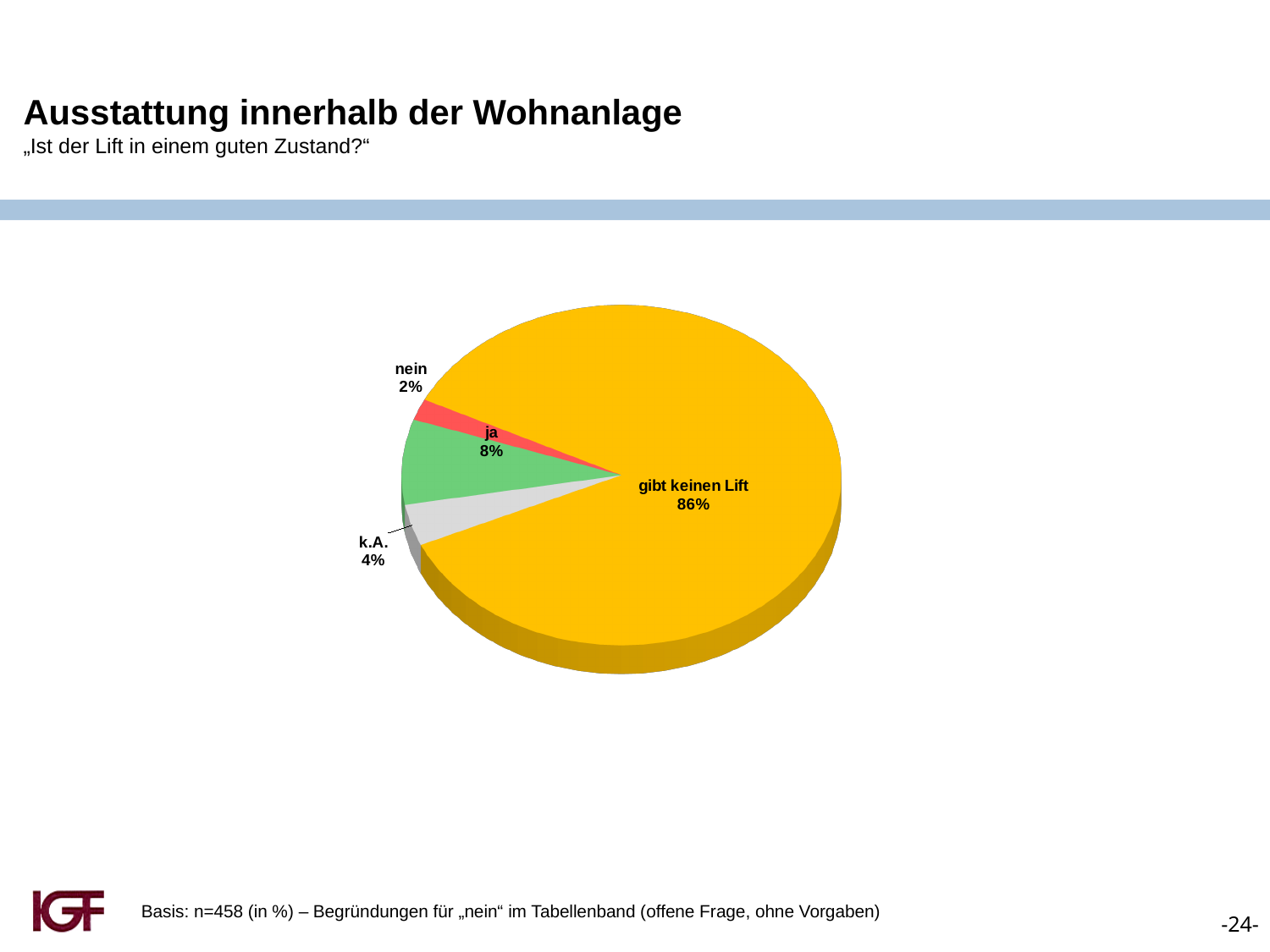
What share of respondents answered "nein"? 2% What share of respondents answered "k.A."? 4% What share of respondents answered "ja"? 8% What kind of chart is shown on the slide? pie chart What is the combined share of "ja" and "nein"? 10% Which is larger, the share for "k.A." or the share for "ja"? ja How many slices does the pie chart have? 4 What colour is the "gibt keinen Lift" slice? yellow Which category has the smallest slice of the pie? nein What share of respondents answered "gibt keinen Lift"? 86% Which category has the largest slice of the pie? gibt keinen Lift What is the difference in percentage points between "ja" and "nein"? 6 percentage points